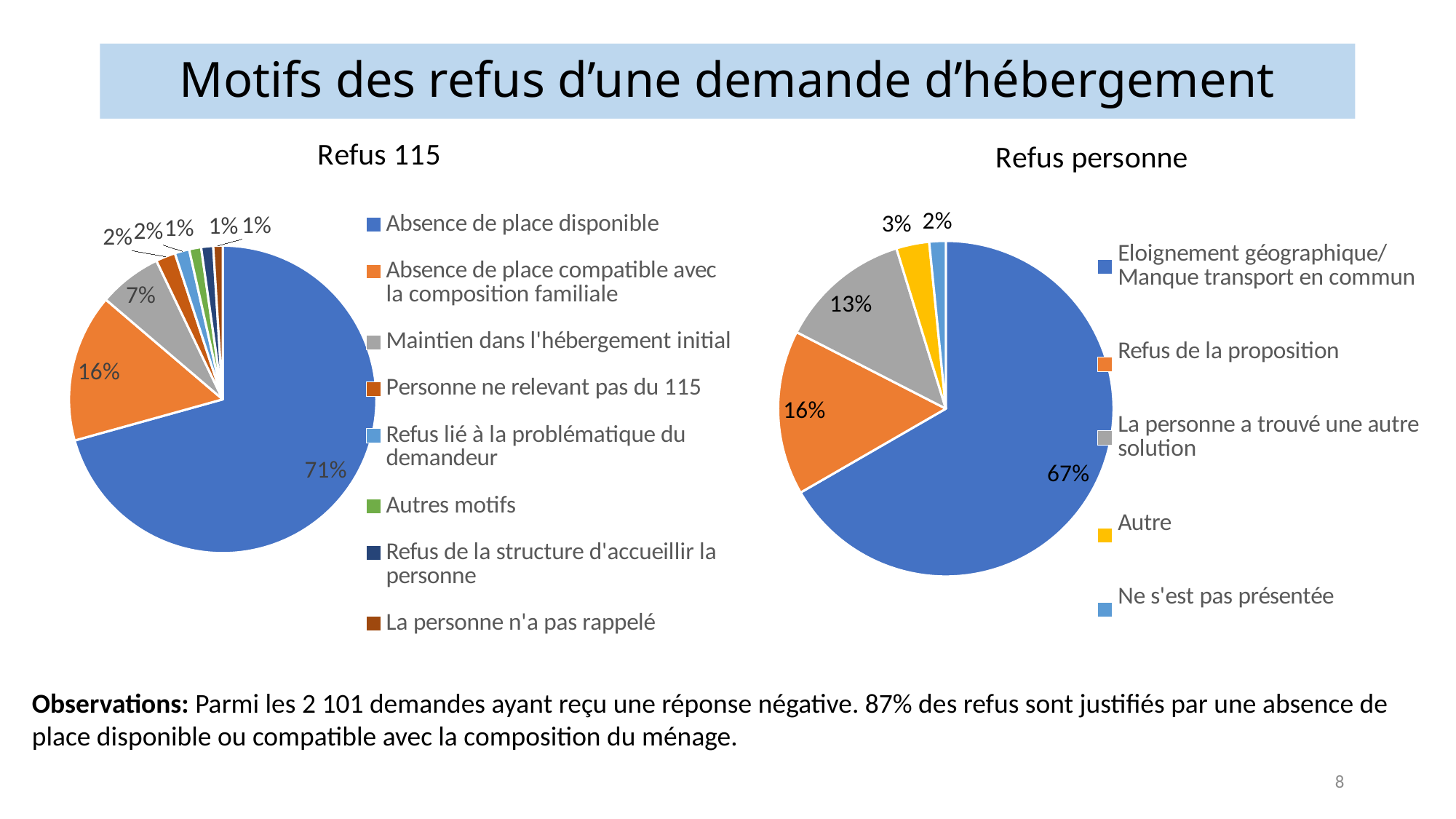
In the 'Refus personne' chart, which category has the smallest slice? Ne s'est pas présentée In the 'Refus personne' chart, what share is shown for 'Eloignement géographique/ Manque transport en commun'? 67% In the 'Refus 115' chart, which category has the largest slice? Absence de place disponible In the 'Refus 115' chart, what percentage is shown for 'Maintien dans l'hébergement initial'? 7% In the 'Refus personne' chart, what percentage is shown for 'La personne a trouvé une autre solution'? 13% In the 'Refus personne' chart, how many categories does the legend list? 5 What is the title of the chart on the left of the slide? Refus 115 In the 'Refus 115' chart, what is the difference between the shares for 'Absence de place disponible' and 'Absence de place compatible avec la composition familiale'? 55% What type of chart is the 'Refus personne' chart? Pie chart In the 'Refus 115' chart, what share of refusals is due to 'Absence de place disponible'? 71% In the 'Refus 115' chart, how many categories does the legend list? 8 In the 'Refus personne' chart, which is larger: 'Refus de la proposition' or 'Autre'? Refus de la proposition